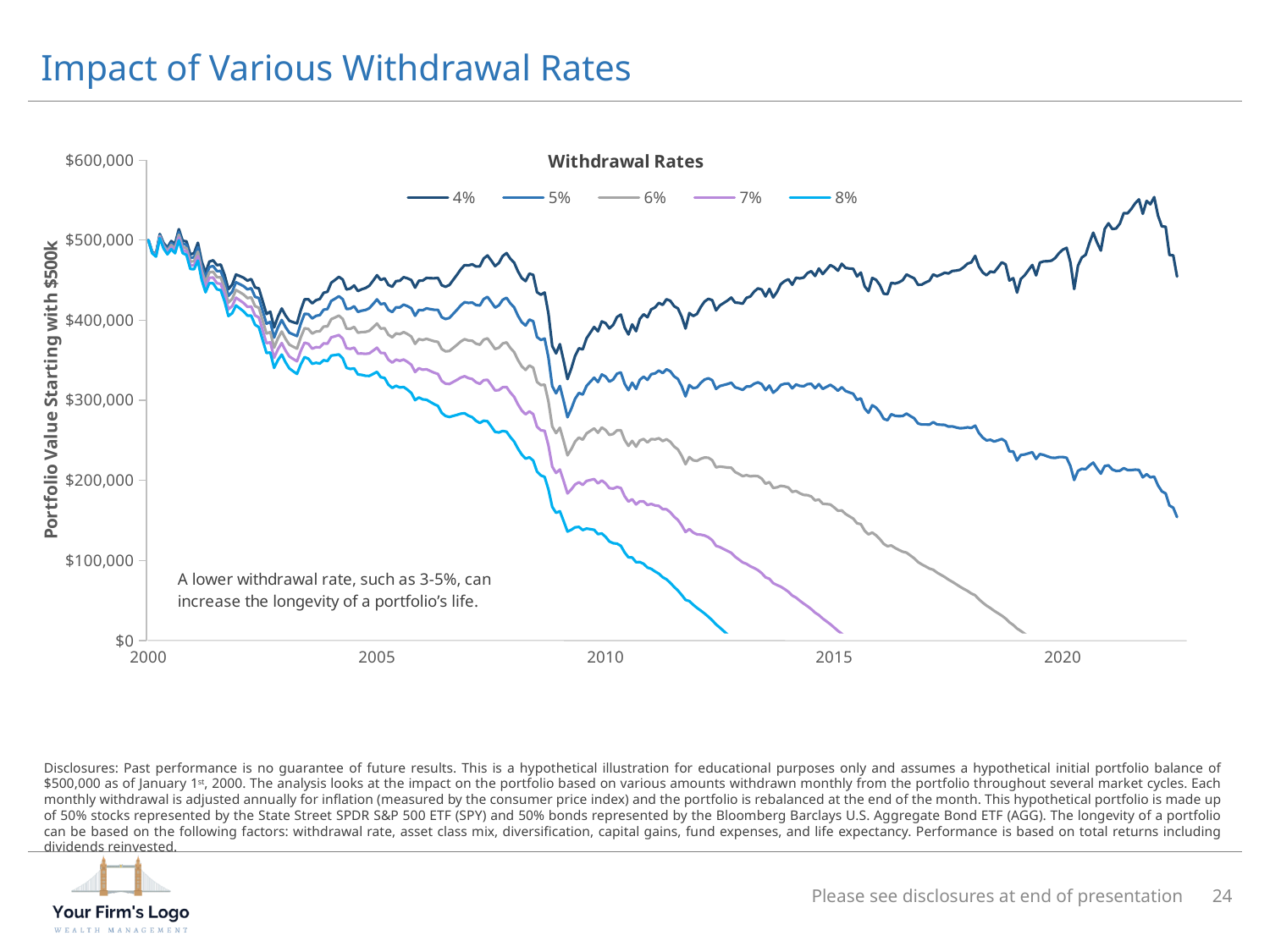
What is the title of the chart? Withdrawal Rates Is the value of the 4% line at the right end of the chart greater or less than $400,000? greater Which withdrawal rate series reaches $0 first? 8% Is the peak value of the 4% line greater or less than $500,000? greater How many series does the legend of the chart list? 5 Which withdrawal rate series ends at the highest portfolio value? 4% Is the value of the 6% line at 2010 greater or less than $300,000? less At 2020, which line is higher: the 4% line or the 5% line? 4% What is the label on the vertical axis of the chart? Portfolio Value Starting with $500k What type of chart is shown on the slide? line chart Does the 8% withdrawal rate line rise or fall over time? fall